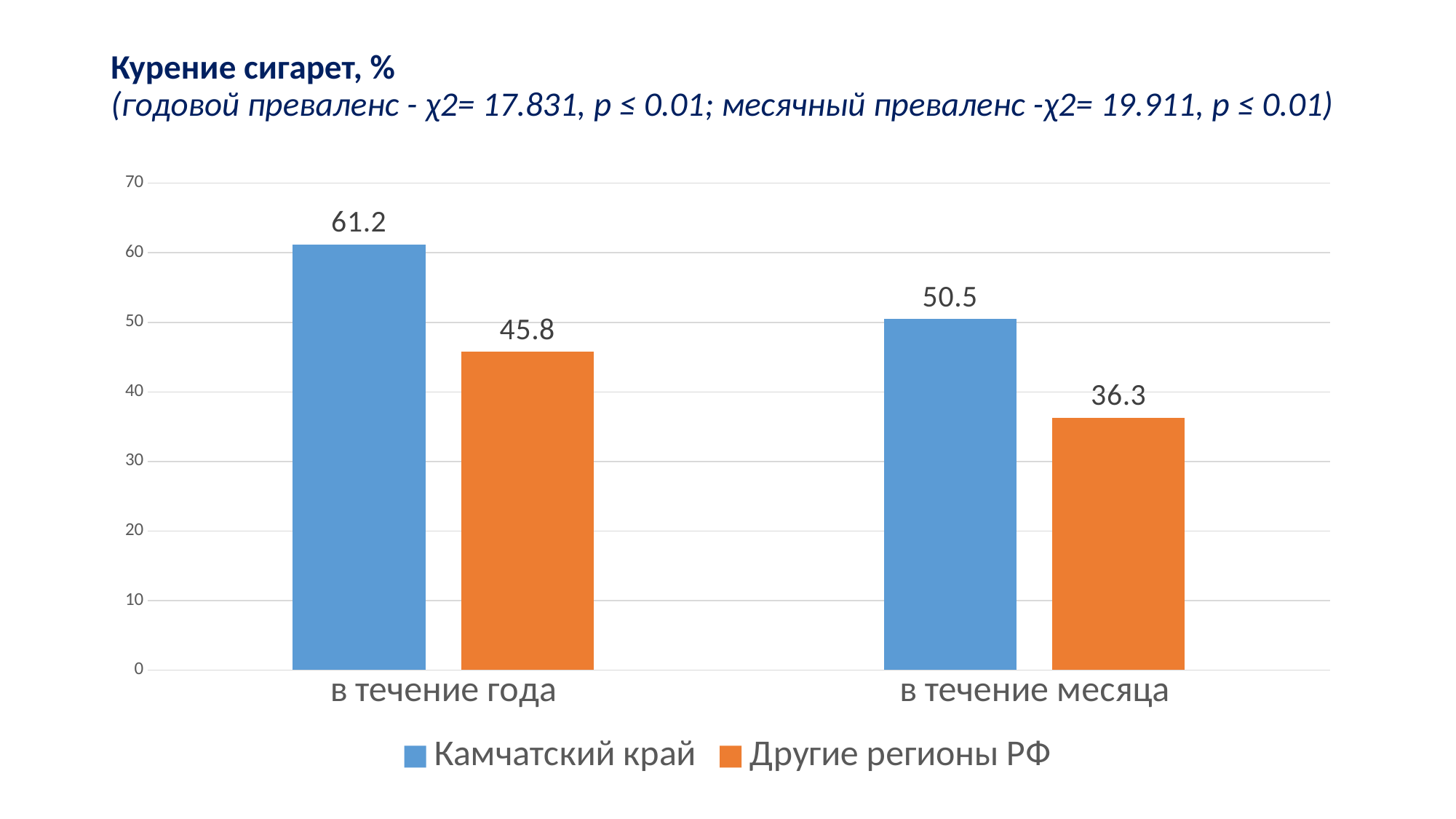
How many categories are shown on the x axis? 2 What is the value for Другие регионы РФ in the category 'в течение года'? 45.8 What is the value for Камчатский край in the category 'в течение месяца'? 50.5 Which bar has the lowest value in the chart? Другие регионы РФ, в течение месяца What is the difference between Камчатский край and Другие регионы РФ in the category 'в течение месяца'? 14.2 What is the difference between Камчатский край and Другие регионы РФ in the category 'в течение года'? 15.4 How many series does the legend list? 2 Which is larger: Камчатский край for 'в течение месяца' or Другие регионы РФ for 'в течение года'? Камчатский край for 'в течение месяца' Which series has the highest value in the chart? Камчатский край What kind of chart is shown on the slide? Bar chart What is the value for Камчатский край in the category 'в течение года'? 61.2 What is the value for Другие регионы РФ in the category 'в течение месяца'? 36.3